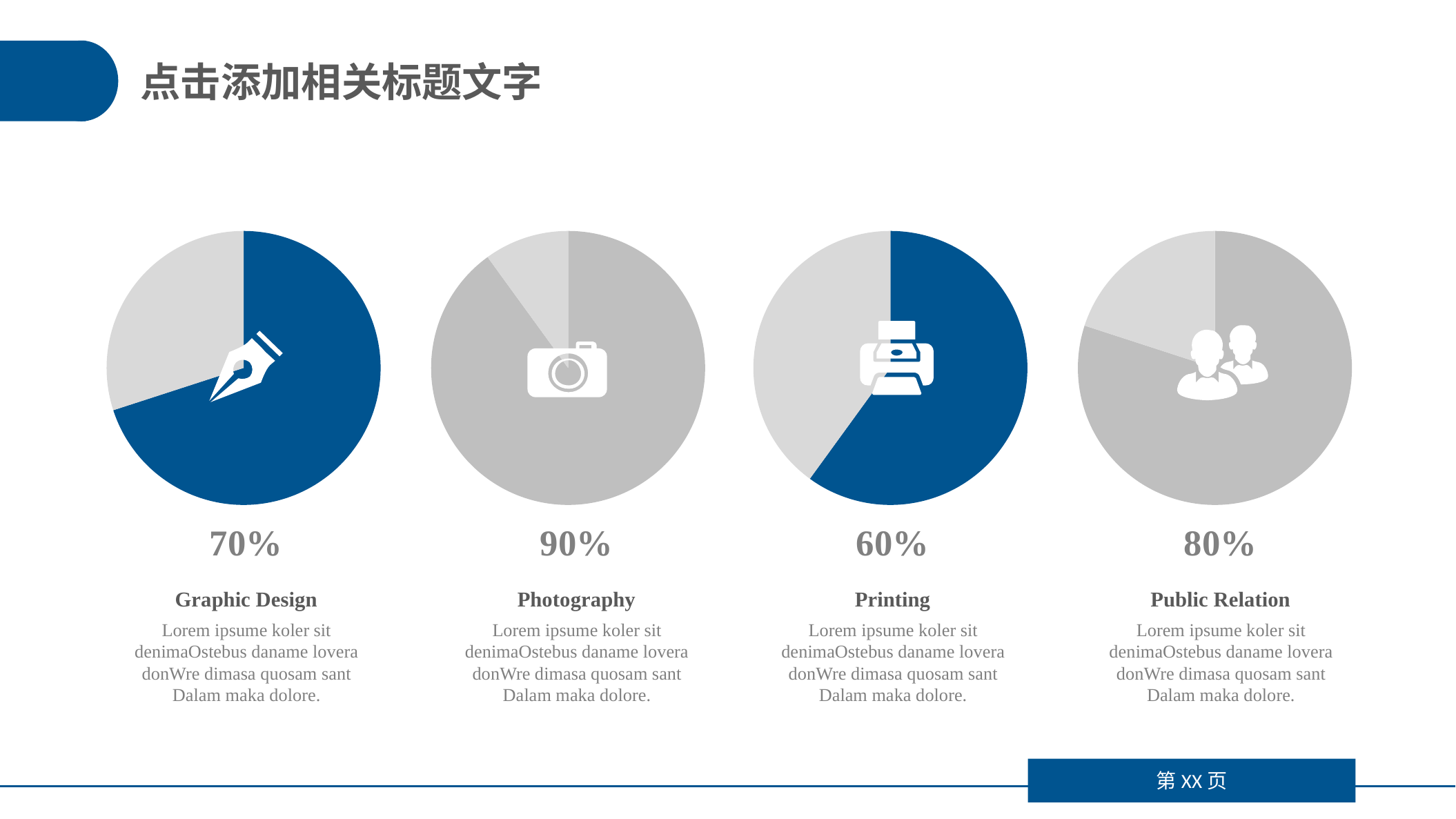
Which two pie charts use a dark blue slice for the highlighted share? Graphic Design and Printing Which of the four pie charts shows the lowest percentage? Printing What kind of chart is used for each of the four categories on the slide? Pie chart Which is larger, the Graphic Design percentage or the Public Relation percentage? Public Relation How many pie charts are shown on the slide? 4 Which of the four pie charts shows the highest percentage? Photography What percentage is shown for the Public Relation pie chart? 80% What is the difference between the Public Relation percentage and the Graphic Design percentage? 10% What percentage is shown for the Printing pie chart? 60% What percentage is shown for the Photography pie chart? 90% What is the difference between the Photography percentage and the Printing percentage? 30% What percentage is shown for the Graphic Design pie chart? 70%